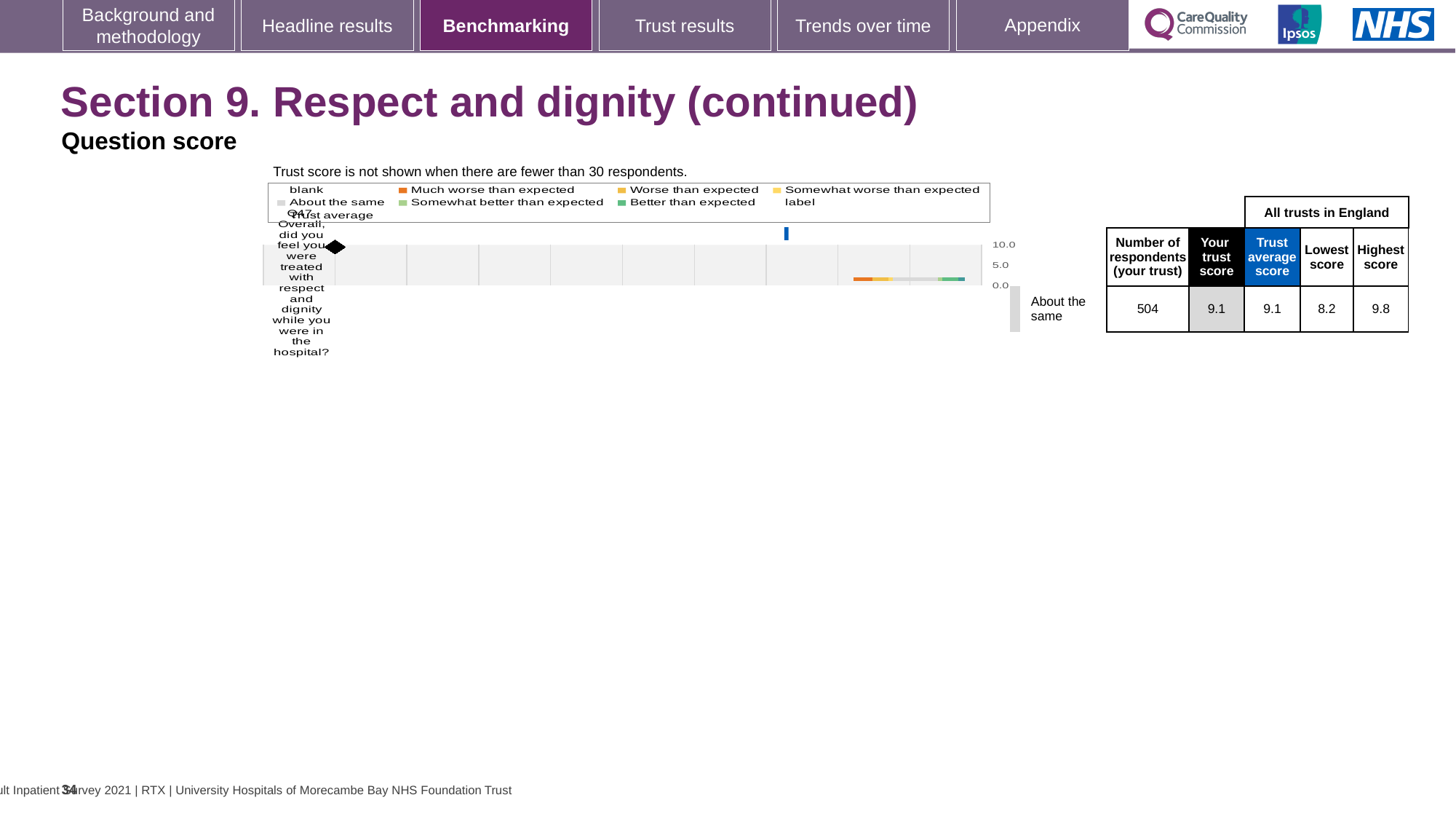
What benchmark category is the trust's Q47 score placed in, as labelled beside the chart? About the same What is the highest tick value shown on the chart's score axis? 10.0 What is the difference between the highest score (9.8) and the lowest score (8.2) shown in the table? 1.6 How many questions (categories) are plotted on the chart? 1 What kind of chart is shown on the slide? bar chart How many respondents from the trust answered Q47, according to the table? 504 What colour does the legend use for 'Much worse than expected'? orange According to the table next to the chart, what is the trust's score for Q47? 9.1 According to the table next to the chart, what is the trust average score for all trusts in England? 9.1 Which question number is plotted on the chart? Q47 According to the table next to the chart, what is the lowest score among all trusts in England? 8.2 According to the table next to the chart, what is the highest score among all trusts in England? 9.8